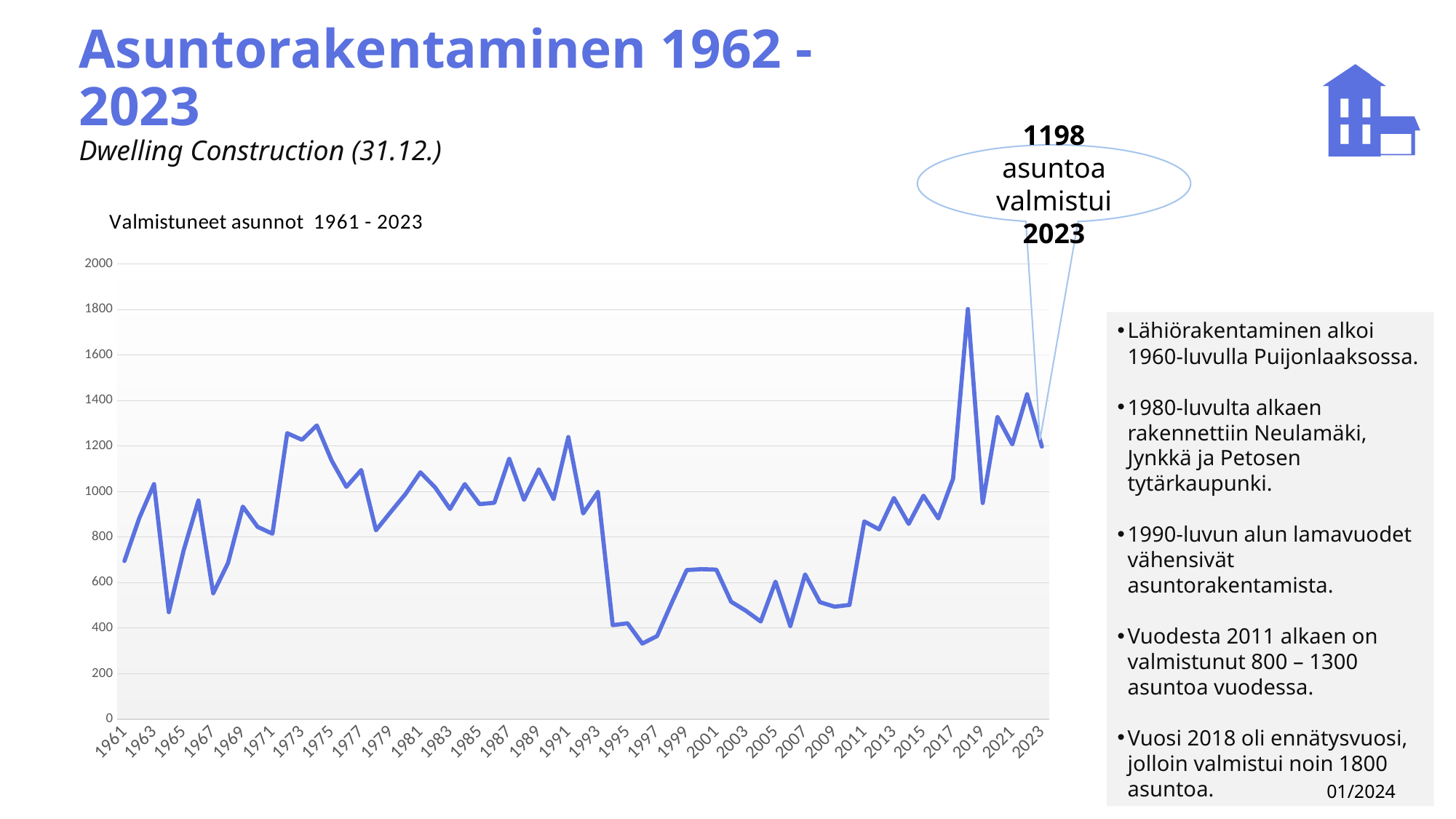
Which year has the larger value, 1963 or 1965? 1963 How many dwellings were completed in 2023 according to the chart's callout? 1198 Which year has the larger value, 2018 or 2023? 2018 Is the value for 1975 greater or less than 1200? less Is the value for 2009 greater or less than 600? less Is the value for 1997 greater or less than 400? less What is the title of the chart? Valmistuneet asunnot 1961 - 2023 Which year has the highest value on the chart? 2018 What kind of chart is shown on the slide? line chart Do the values rise or fall between 1991 and 1996? fall